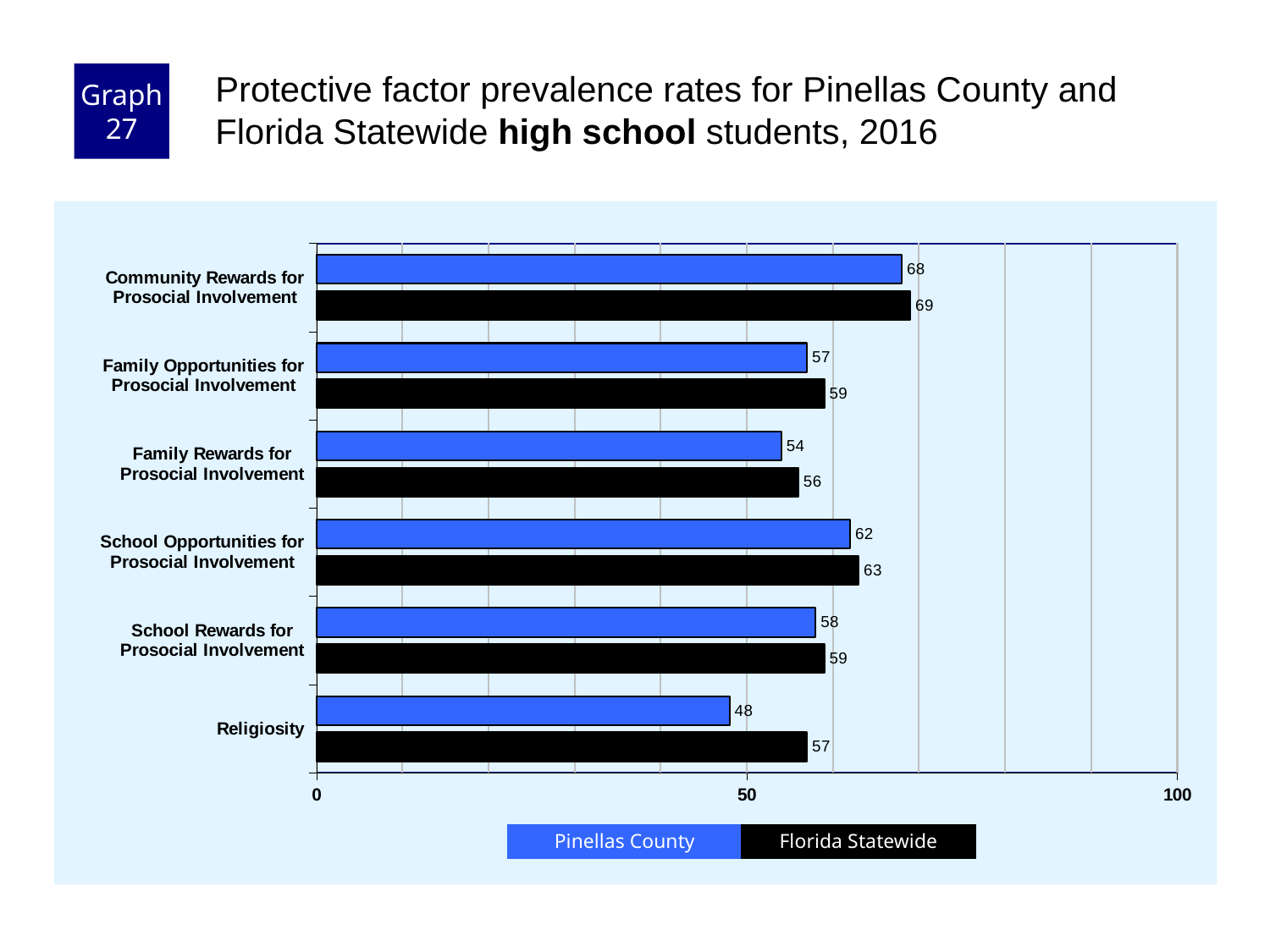
Which category has the highest Pinellas County value? Community Rewards for Prosocial Involvement How many series does the legend list? 2 Which category has the lowest Pinellas County value? Religiosity What kind of chart is shown on the slide? bar chart What is the Florida Statewide value for Family Rewards for Prosocial Involvement? 56 What is the Pinellas County value for Community Rewards for Prosocial Involvement? 68 How many categories are shown on the chart? 6 What is the difference between the Florida Statewide and Pinellas County values for Religiosity? 9 Is the Pinellas County value for Religiosity greater or less than 50? less What is the Florida Statewide value for Religiosity? 57 Which is larger for School Opportunities for Prosocial Involvement: the Pinellas County value or the Florida Statewide value? Florida Statewide What is the difference between the Florida Statewide and Pinellas County values for Family Opportunities for Prosocial Involvement? 2